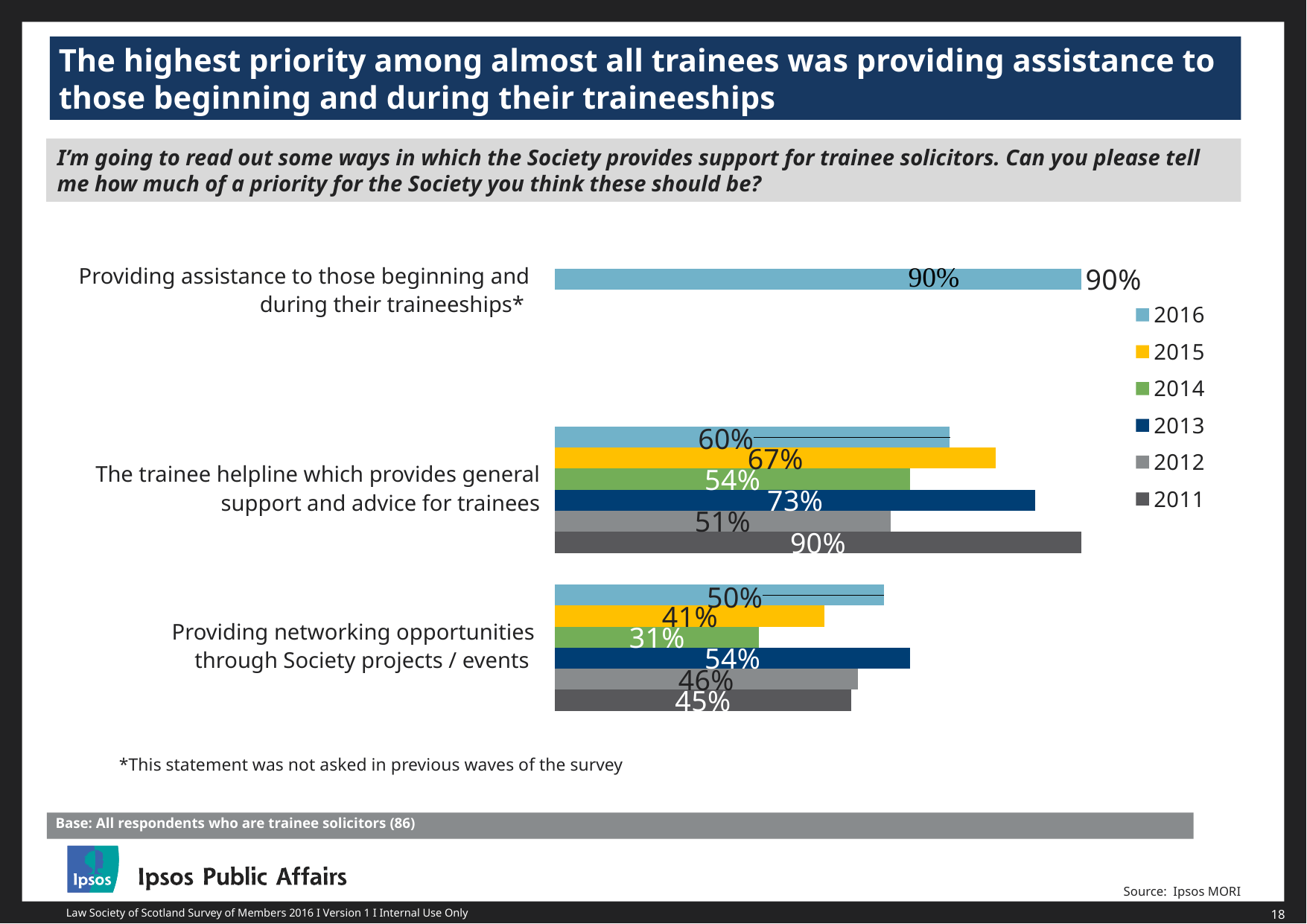
How many categories are shown on the chart? 3 What is the 2014 value for 'Providing networking opportunities through Society projects / events'? 31% What is the 2016 value for 'Providing assistance to those beginning and during their traineeships'? 90% What is the 2013 value for 'The trainee helpline which provides general support and advice for trainees'? 73% What is the 2012 value for 'The trainee helpline which provides general support and advice for trainees'? 51% For 'Providing networking opportunities through Society projects / events', which is larger: the 2012 value or the 2011 value? 2012 Which year has the lowest value for 'Providing networking opportunities through Society projects / events'? 2014 What kind of chart is shown on the slide? Bar chart Which category has only a single bar (for 2016) plotted? Providing assistance to those beginning and during their traineeships Which year has the highest value for 'The trainee helpline which provides general support and advice for trainees'? 2011 What is the difference between the 2015 and 2016 values for 'The trainee helpline which provides general support and advice for trainees'? 7 percentage points How many series does the legend list? 6